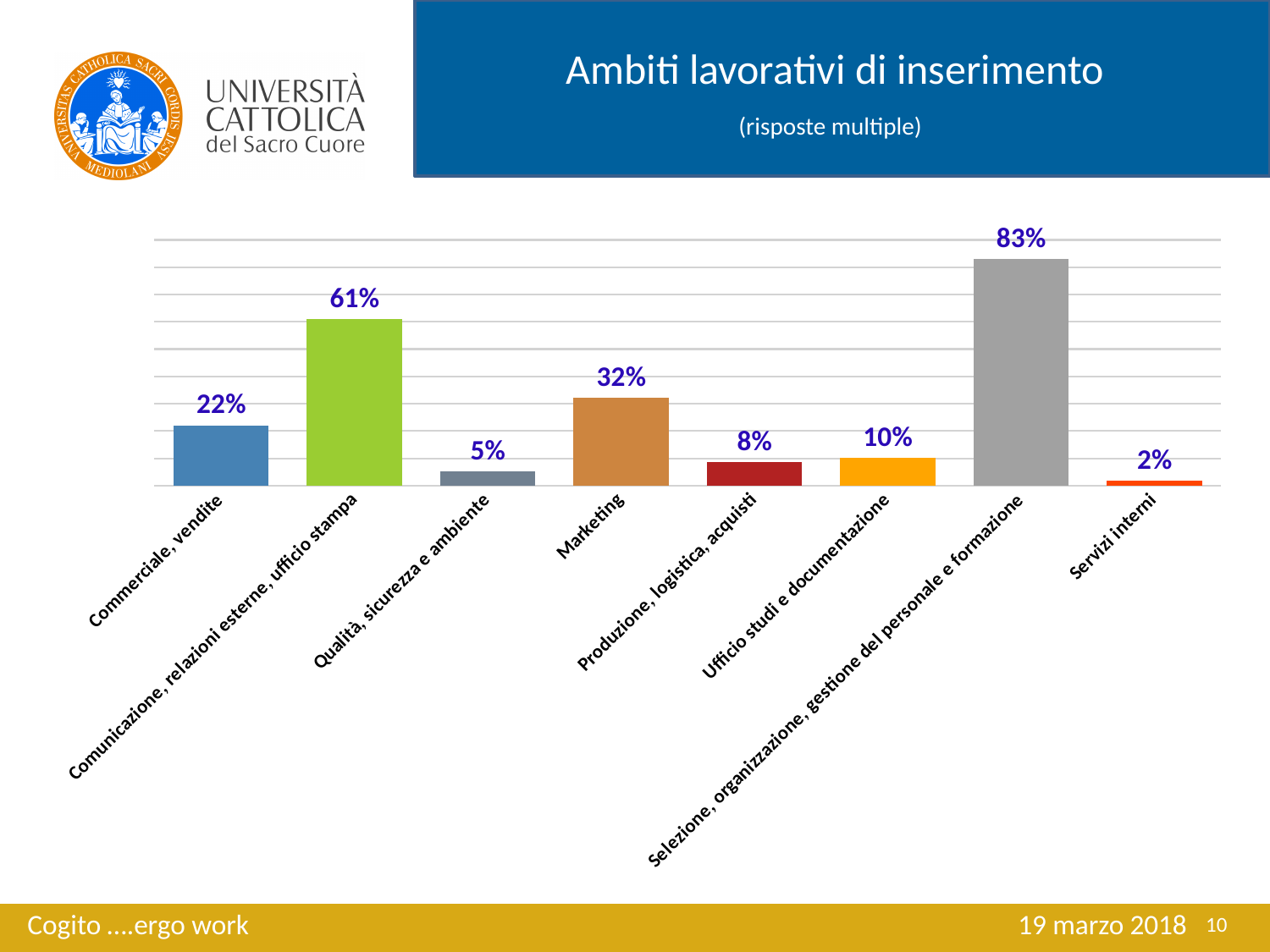
What is the difference between the values for Comunicazione, relazioni esterne, ufficio stampa and Marketing? 29% What is the value for Ufficio studi e documentazione? 10% What is the value for Servizi interni? 2% What kind of chart is shown on the slide? Bar chart What is the value for Marketing? 32% What is the title of the chart on the slide? Ambiti lavorativi di inserimento How many categories are shown in the chart? 8 Which is larger, the value for Produzione, logistica, acquisti or the value for Ufficio studi e documentazione? Ufficio studi e documentazione Which category has the lowest value? Servizi interni What is the difference between the values for Selezione, organizzazione, gestione del personale e formazione and Commerciale, vendite? 61% Which category has the highest value? Selezione, organizzazione, gestione del personale e formazione What is the value for Commerciale, vendite? 22%